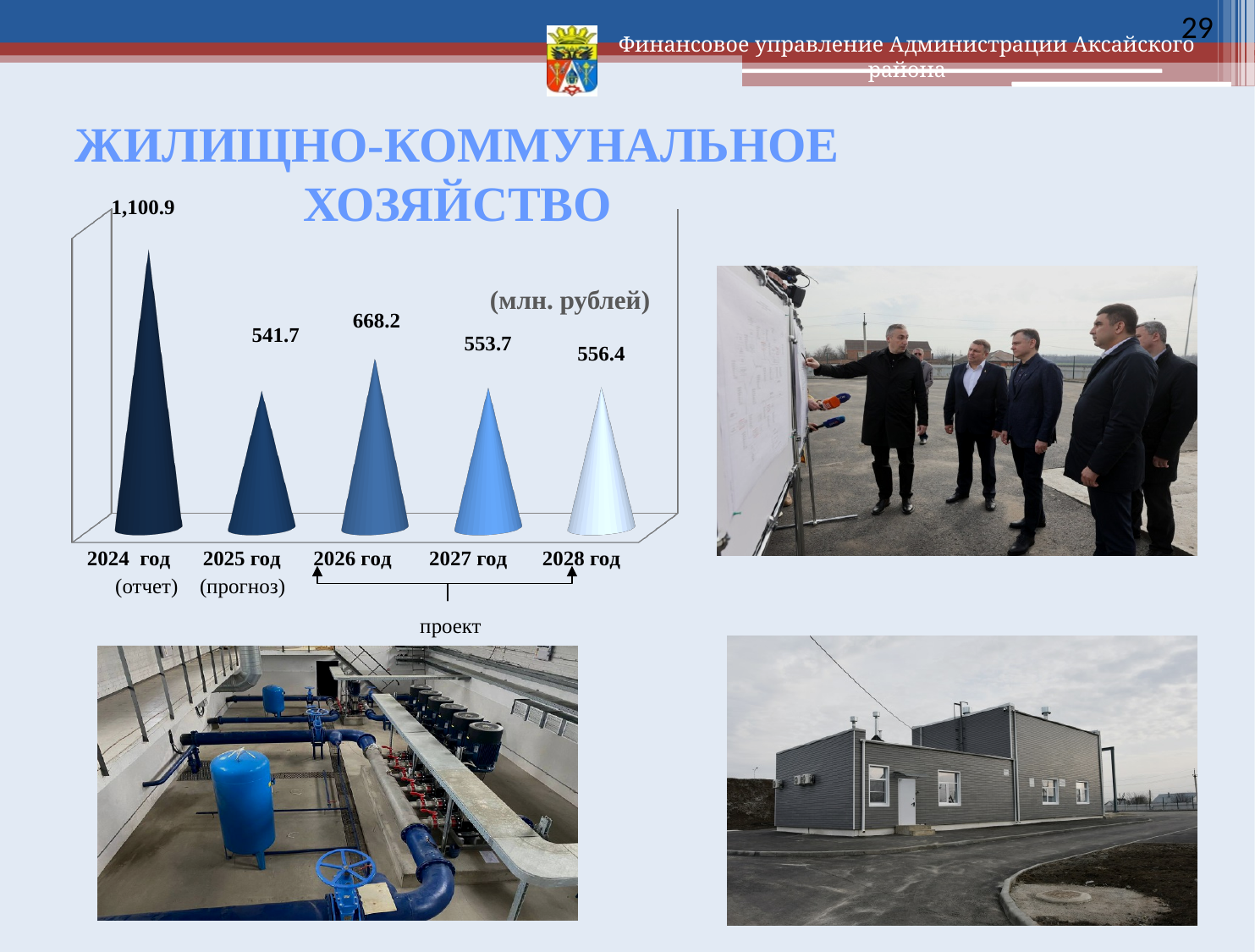
What is the value for 2026 год? 668.2 Which year has the lowest value? 2025 год What is the difference between the values for 2026 год and 2027 год? 114.5 How many years are shown on the chart? 5 Which year has the highest value? 2024 год What is the value for 2024 год (отчет)? 1,100.9 What is the value for 2025 год (прогноз)? 541.7 What is the value for 2028 год? 556.4 In what units are the chart values given? млн. рублей Which is larger, the value for 2027 год or 2028 год? 2028 год What kind of chart is shown on the slide? Bar chart What is the difference between the values for 2024 год and 2025 год? 559.2